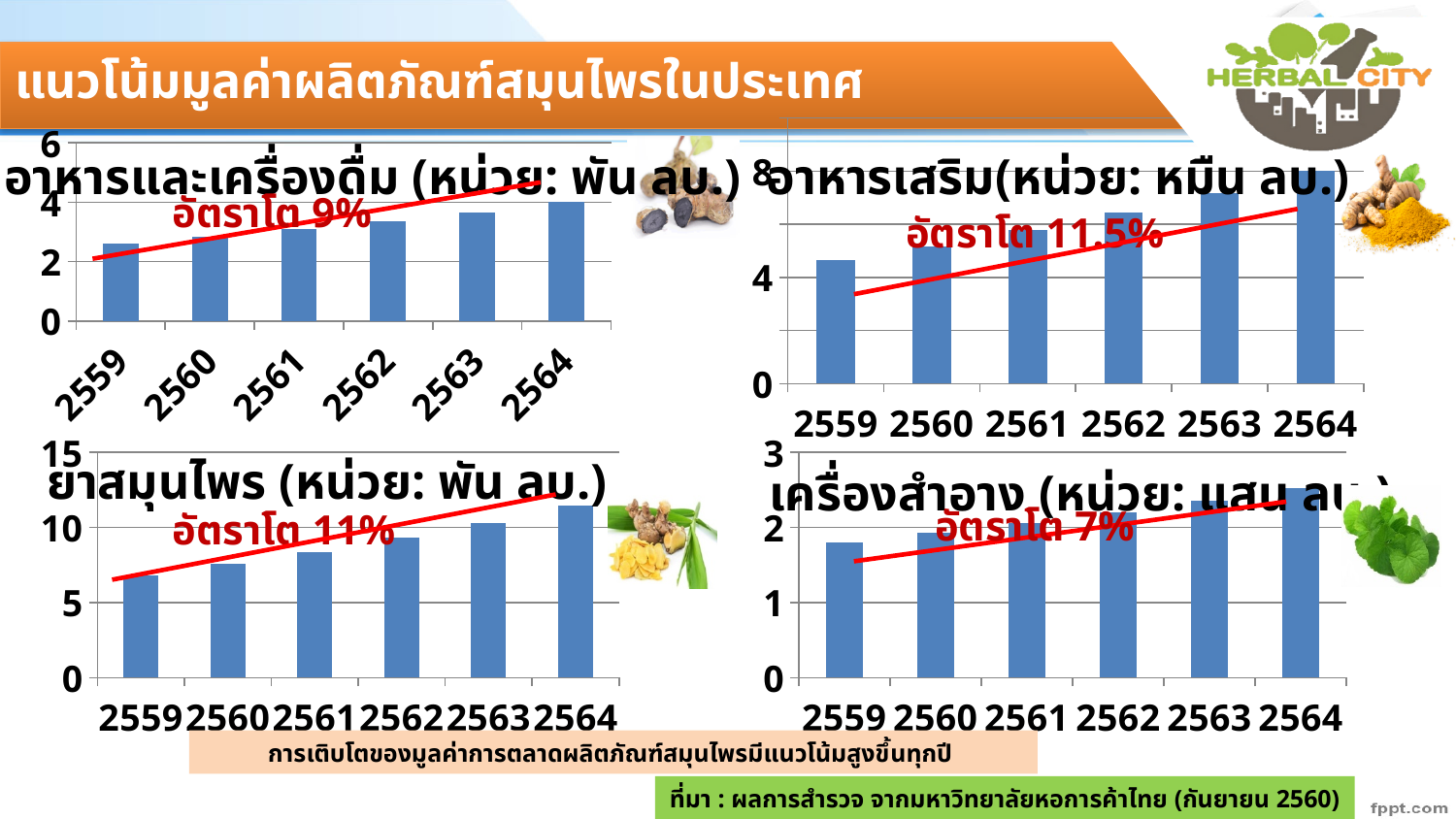
In the top-right chart titled อาหารเสริม(หน่วย: หมื่น ลบ.), is the value for 2559 greater or less than 4? greater How many years are shown on the x axis of the bottom-left chart titled ยาสมุนไพร (หน่วย: พัน ลบ.)? 6 What kind of chart is the top-left chart titled อาหารและเครื่องดื่ม (หน่วย: พัน ลบ.)? bar chart In the bottom-left chart titled ยาสมุนไพร (หน่วย: พัน ลบ.), is the value for 2562 greater or less than 10? less In the top-left chart titled อาหารและเครื่องดื่ม (หน่วย: พัน ลบ.), is the value for 2559 greater or less than 2? greater In the bottom-right chart titled เครื่องสำอาง (หน่วย: แสน ลบ.), which year has the lowest bar? 2559 In the bottom-right chart titled เครื่องสำอาง (หน่วย: แสน ลบ.), which is larger, the value for 2559 or the value for 2564? 2564 In the top-right chart titled อาหารเสริม(หน่วย: หมื่น ลบ.), which year has the highest bar? 2564 In the top-left chart titled อาหารและเครื่องดื่ม (หน่วย: พัน ลบ.), do the values rise or fall from 2559 to 2564? rise What growth rate (อัตราโต) is printed on the top-right chart titled อาหารเสริม(หน่วย: หมื่น ลบ.)? 11.5%